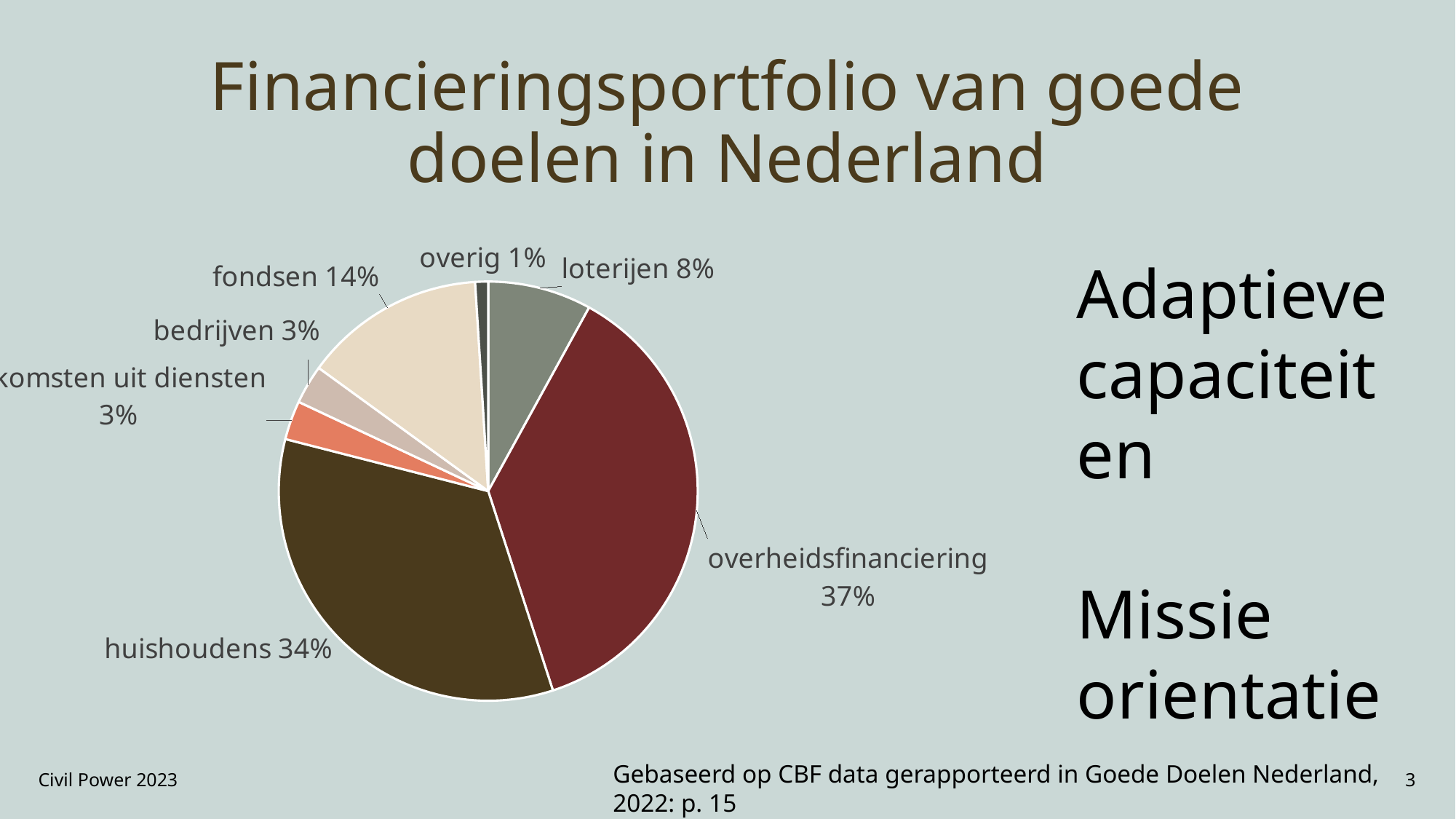
How many slices does the pie chart have? 7 Which category has the smallest slice of the pie? overig What is the difference in percentage points between overheidsfinanciering and huishoudens? 3 What share of the pie does overig have? 1% What share of the pie does huishoudens have? 34% Which is larger, the share for fondsen or the share for loterijen? fondsen What kind of chart is shown on the slide? pie chart What share of the pie does loterijen have? 8% Which category has the largest slice of the pie? overheidsfinanciering